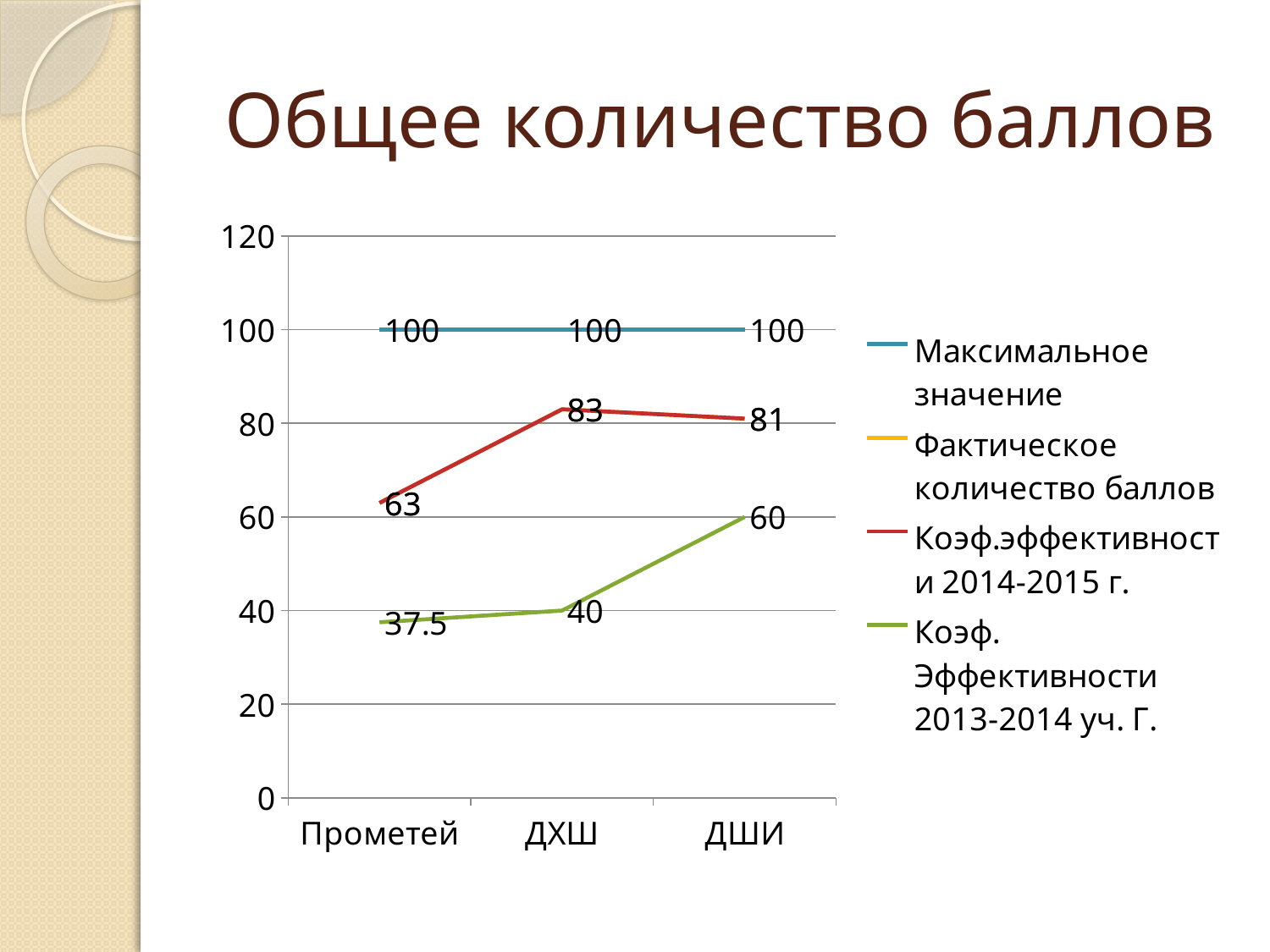
What is the value of Максимальное значение for ДХШ? 100 Does the Коэф. Эффективности 2013-2014 уч. Г. line rise or fall from Прометей to ДШИ? rise How many series does the legend list? 4 Which category has the highest value for Коэф. Эффективности 2013-2014 уч. Г.? ДШИ What type of chart is shown on the slide? line chart For ДШИ, which is larger: Коэф.эффективности 2014-2015 г. or Коэф. Эффективности 2013-2014 уч. Г.? Коэф.эффективности 2014-2015 г. Which category has the lowest value for Коэф.эффективности 2014-2015 г.? Прометей What is the value of Коэф.эффективности 2014-2015 г. for ДХШ? 83 What is the value of Коэф. Эффективности 2013-2014 уч. Г. for Прометей? 37.5 What is the value of Коэф.эффективности 2014-2015 г. for ДШИ? 81 How many categories are shown on the x axis? 3 What is the difference between the Коэф.эффективности 2014-2015 г. value for ДХШ and for Прометей? 20